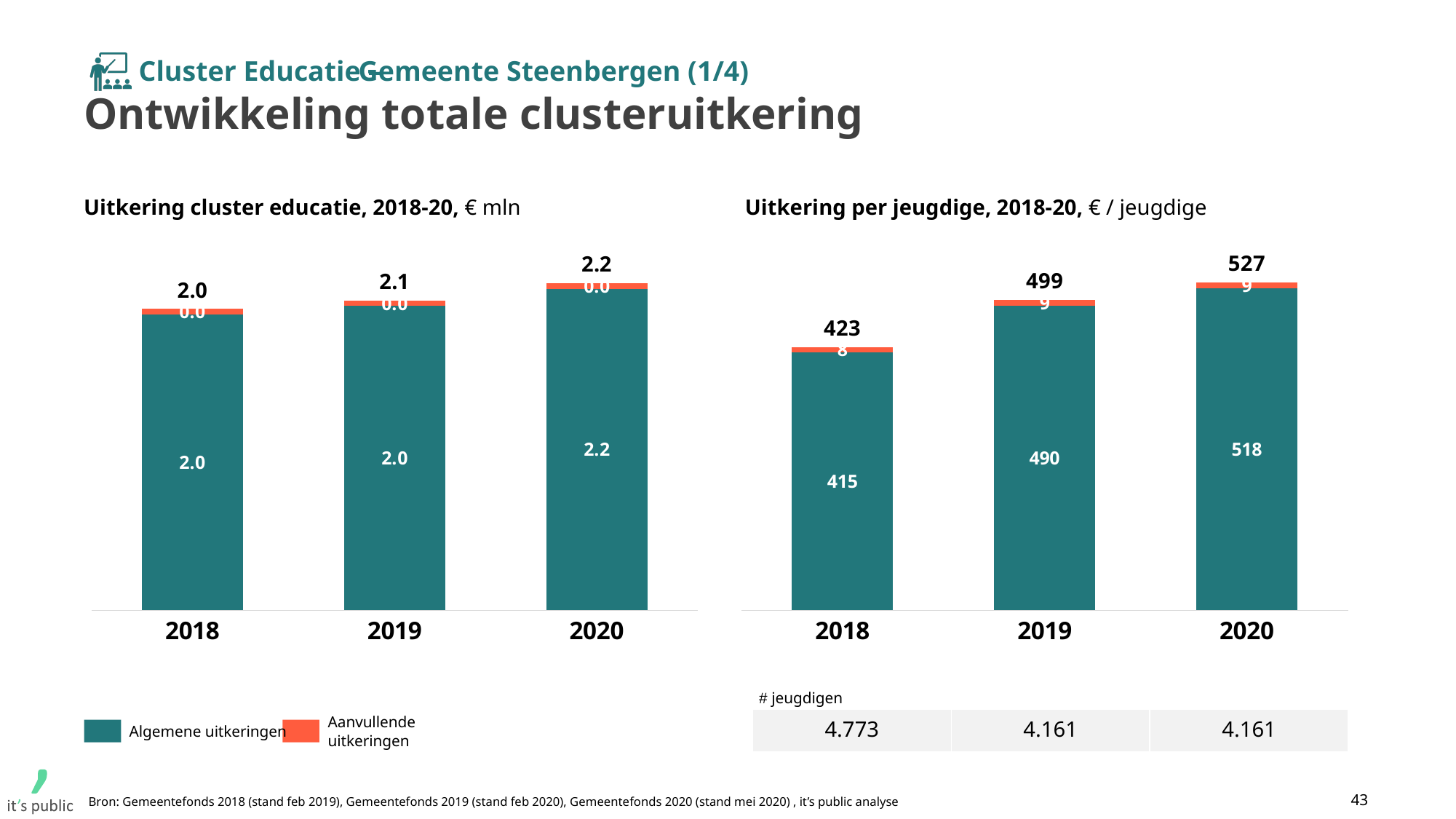
How many series does the legend list for the charts on this slide? 2 In the 'Uitkering per jeugdige' chart, what is the difference between the total for 2020 and the total for 2018? 104 In the 'Uitkering cluster educatie' chart, what is the value of Algemene uitkeringen for 2020? 2.2 In the 'Uitkering per jeugdige' chart, is the Algemene uitkeringen value larger in 2019 or in 2020? 2020 In the 'Uitkering per jeugdige' chart, which year has the lowest total? 2018 In the 'Uitkering per jeugdige' chart, what is the total value for 2020? 527 In the 'Uitkering cluster educatie' chart, what is the total value for 2019? 2.1 In the 'Uitkering per jeugdige' chart, what is the value of Algemene uitkeringen for 2018? 415 In the 'Uitkering per jeugdige' chart, what is the value of Aanvullende uitkeringen for 2019? 9 How many years are shown on the x axis of the 'Uitkering cluster educatie' chart? 3 Do the totals in the 'Uitkering per jeugdige' chart rise or fall from 2018 to 2020? rise In the 'Uitkering per jeugdige' chart, which year has the highest total? 2020